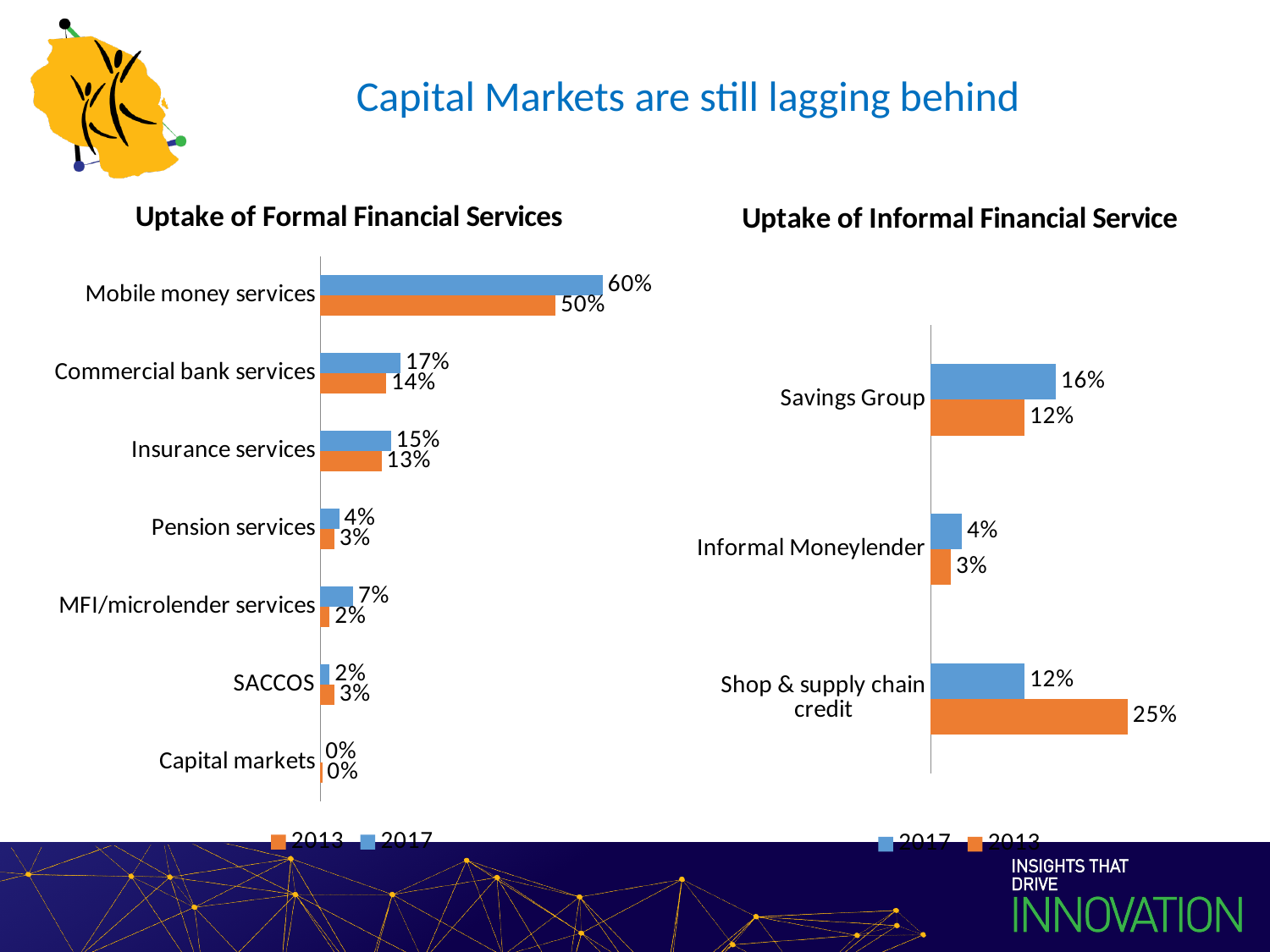
In the 'Uptake of Formal Financial Services' chart, what is the difference between the 2017 and 2013 values for Mobile money services? 10% In the 'Uptake of Formal Financial Services' chart, which category has the lowest 2017 value? Capital markets In the 'Uptake of Informal Financial Service' chart, how many categories are shown? 3 In the 'Uptake of Formal Financial Services' chart, what is the 2013 value for Commercial bank services? 14% In the 'Uptake of Informal Financial Service' chart, what is the difference between the 2013 and 2017 values for Shop & supply chain credit? 13% What type of chart is the 'Uptake of Informal Financial Service' chart? Bar chart In the 'Uptake of Formal Financial Services' chart, which category has the highest 2017 value? Mobile money services How many series does the legend of the 'Uptake of Formal Financial Services' chart list? 2 In the 'Uptake of Informal Financial Service' chart, what is the 2013 value for Shop & supply chain credit? 25% In the 'Uptake of Informal Financial Service' chart, which is larger for Savings Group: the 2017 value or the 2013 value? 2017 In the 'Uptake of Formal Financial Services' chart, how many categories are shown? 7 In the 'Uptake of Formal Financial Services' chart, what is the 2017 value for Mobile money services? 60%